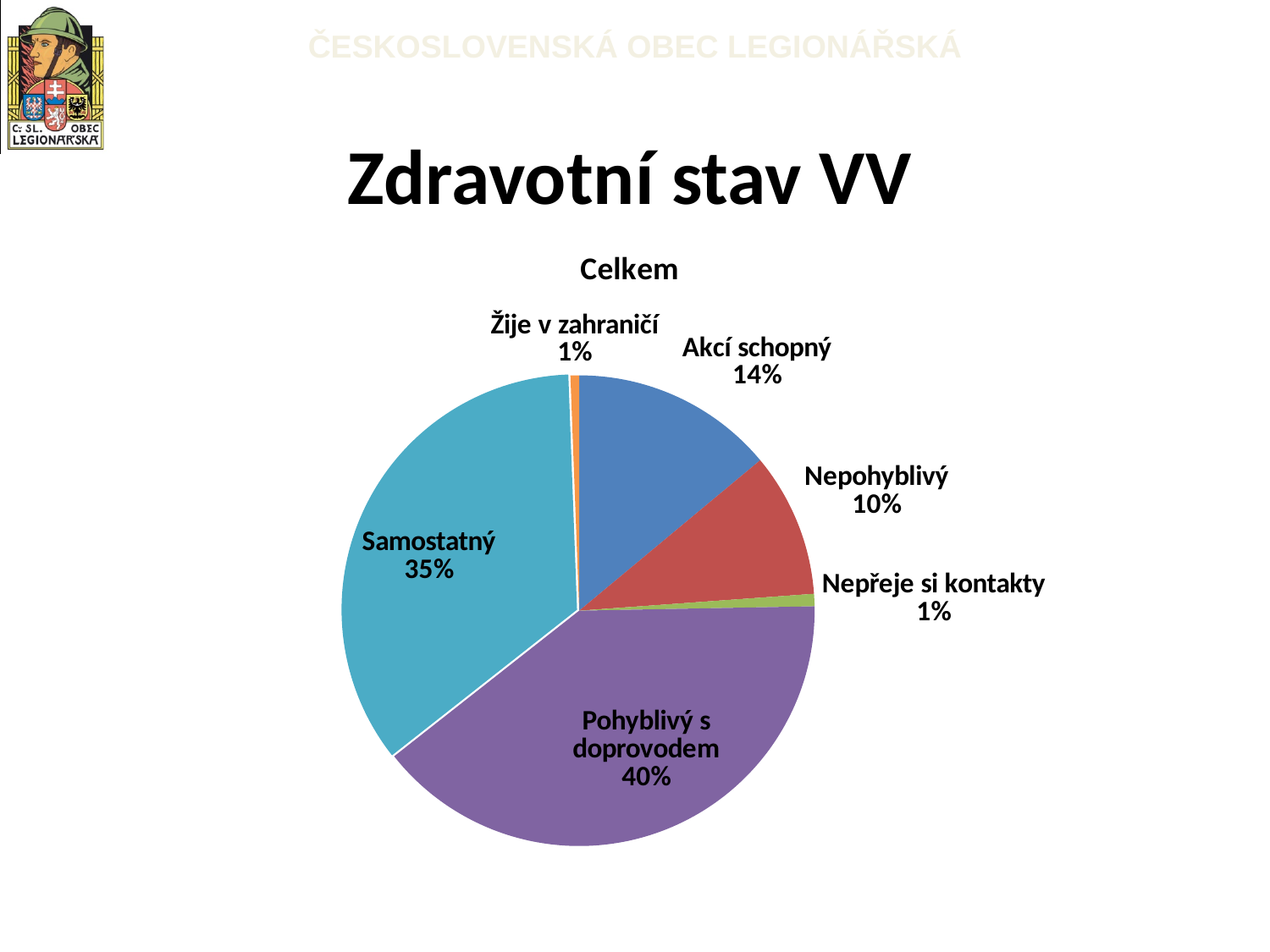
What is the combined share of Akcí schopný and Nepohyblivý? 24% What percentage is shown for Nepohyblivý? 10% Which is larger, Akcí schopný or Nepohyblivý? Akcí schopný What share of the pie is labelled Pohyblivý s doprovodem? 40% Which category has the largest slice of the pie? Pohyblivý s doprovodem What is the difference in percentage points between Pohyblivý s doprovodem and Samostatný? 5 What share of the pie is labelled Samostatný? 35% What is the title of the chart? Celkem How many slices does the pie chart have? 6 What percentage is shown for Žije v zahraničí? 1% What kind of chart is shown on the slide? pie chart What percentage is shown for Akcí schopný? 14%